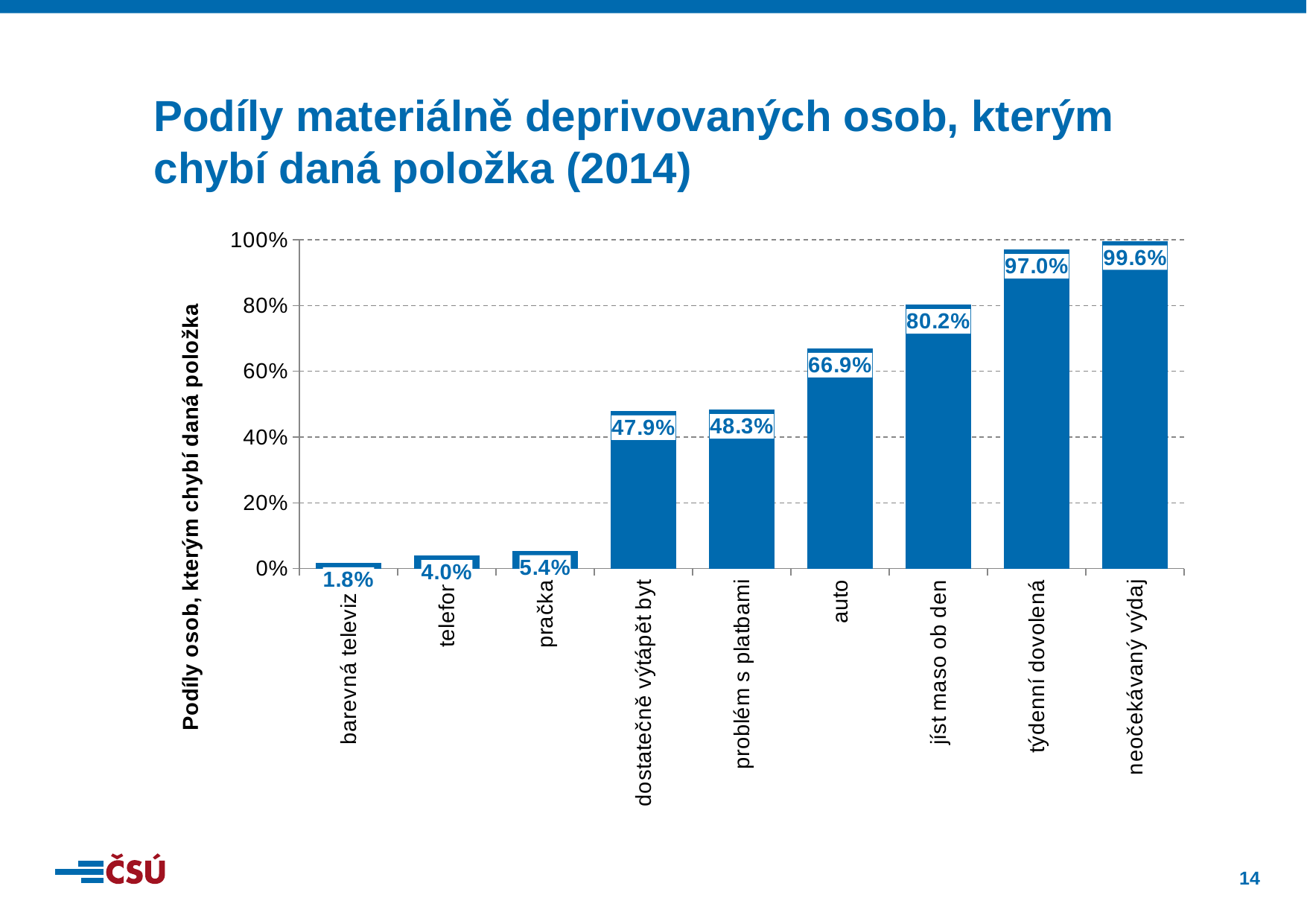
What kind of chart is shown on the slide? bar chart Is the value for 'problém s platbami' greater or less than 40%? greater How many categories are shown on the x axis? 9 Which category has the lowest value? barevná televize What is the label of the vertical axis? Podíly osob, kterým chybí daná položka What is the value for 'barevná televize'? 1.8% Which is larger, the value for 'pračka' or the value for 'telefon'? pračka What is the value for 'auto'? 66.9% What is the difference between the values for 'jíst maso ob den' and 'auto'? 13.3% Which category has the highest value? neočekávaný výdaj What is the value for 'týdenní dovolená'? 97.0% Do the values rise or fall from left to right along the x axis? rise